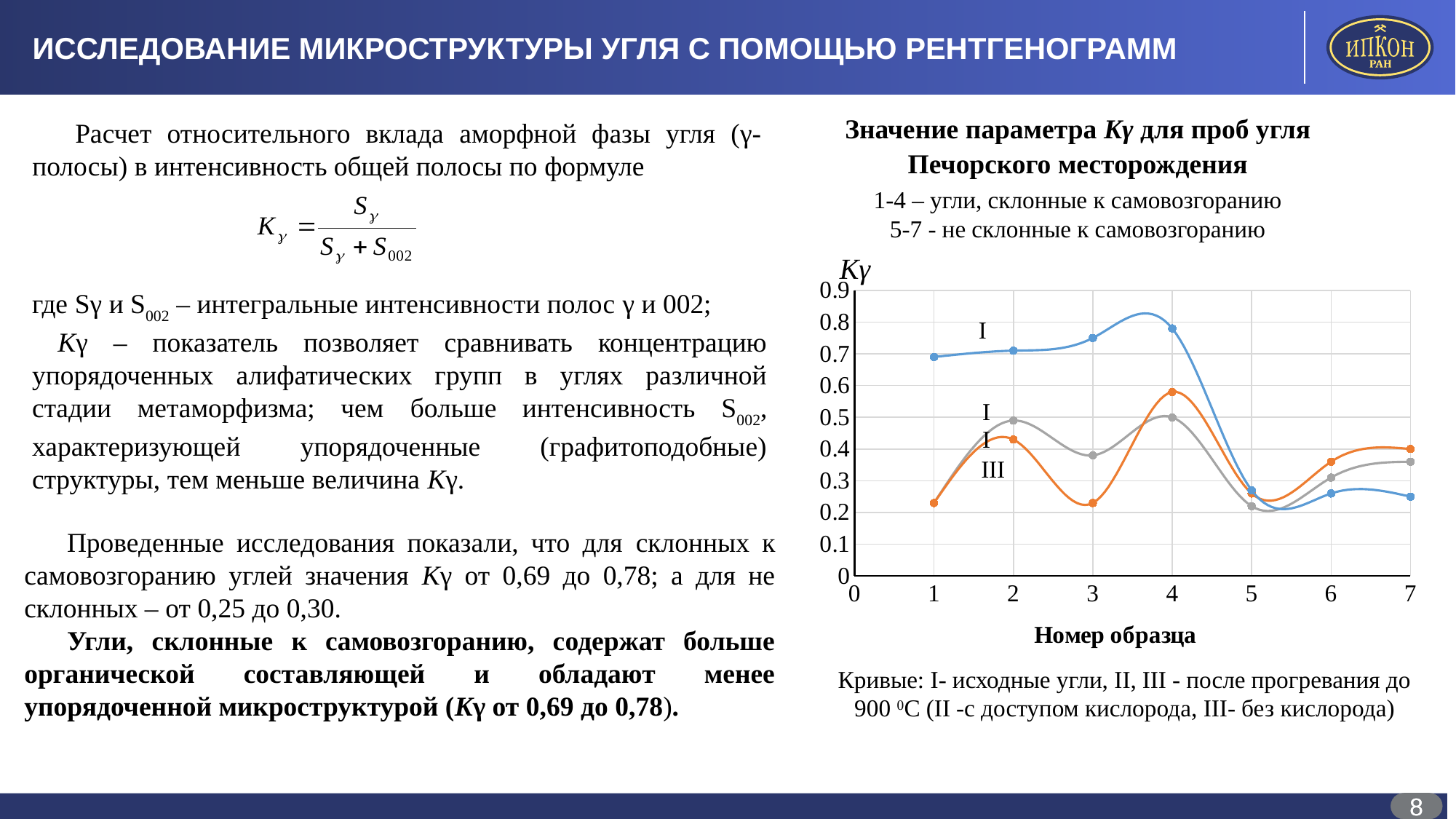
At sample 4, which curve has the larger value, curve I or curve II? curve I Does curve I rise or fall from sample 1 to sample 4? rise How many coal samples (points along the x axis) are plotted on the chart? 7 Is the value of curve I for sample 7 greater or less than 0.3? less What is the title of the x axis of the chart? Номер образца What kind of chart is shown on the slide? line chart For which sample number does curve I reach its highest value? 4 How many curves are plotted on the chart? 3 Is the value of curve I for sample 4 greater or less than 0.7? greater